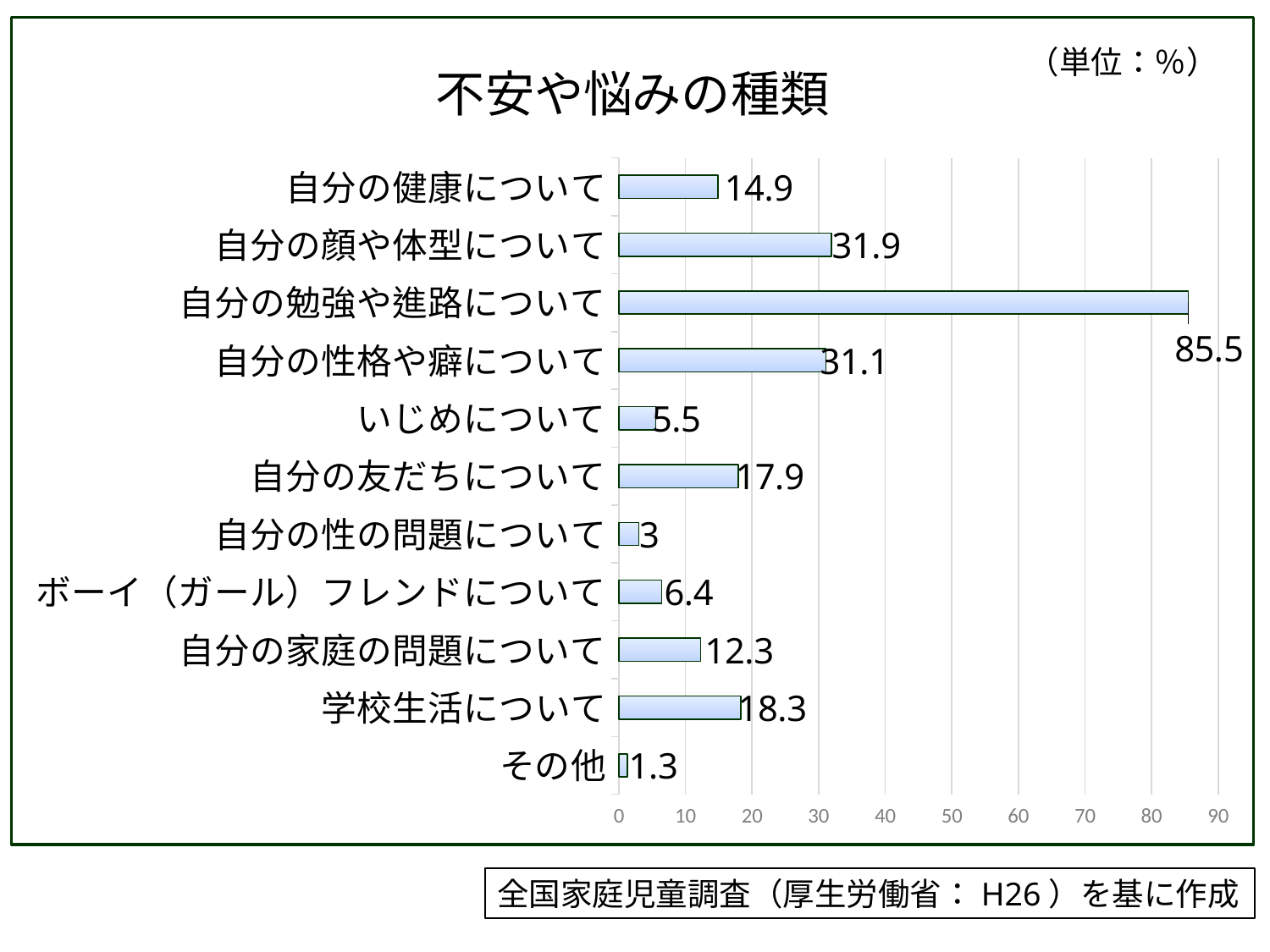
Which category has the lowest value? その他 What unit is indicated for the values in the chart? % What is the title of the chart? 不安や悩みの種類 Is the value for 自分の健康について greater or less than 20? less What kind of chart is this? bar chart Which category has the highest value? 自分の勉強や進路について What is the value for 自分の勉強や進路について? 85.5 What is the value for 自分の家庭の問題について? 12.3 What is the value for いじめについて? 5.5 How many categories are shown in the chart? 11 Which is larger, 学校生活について or 自分の友だちについて? 学校生活について What is the difference between 自分の顔や体型について and 自分の性格や癖について? 0.8